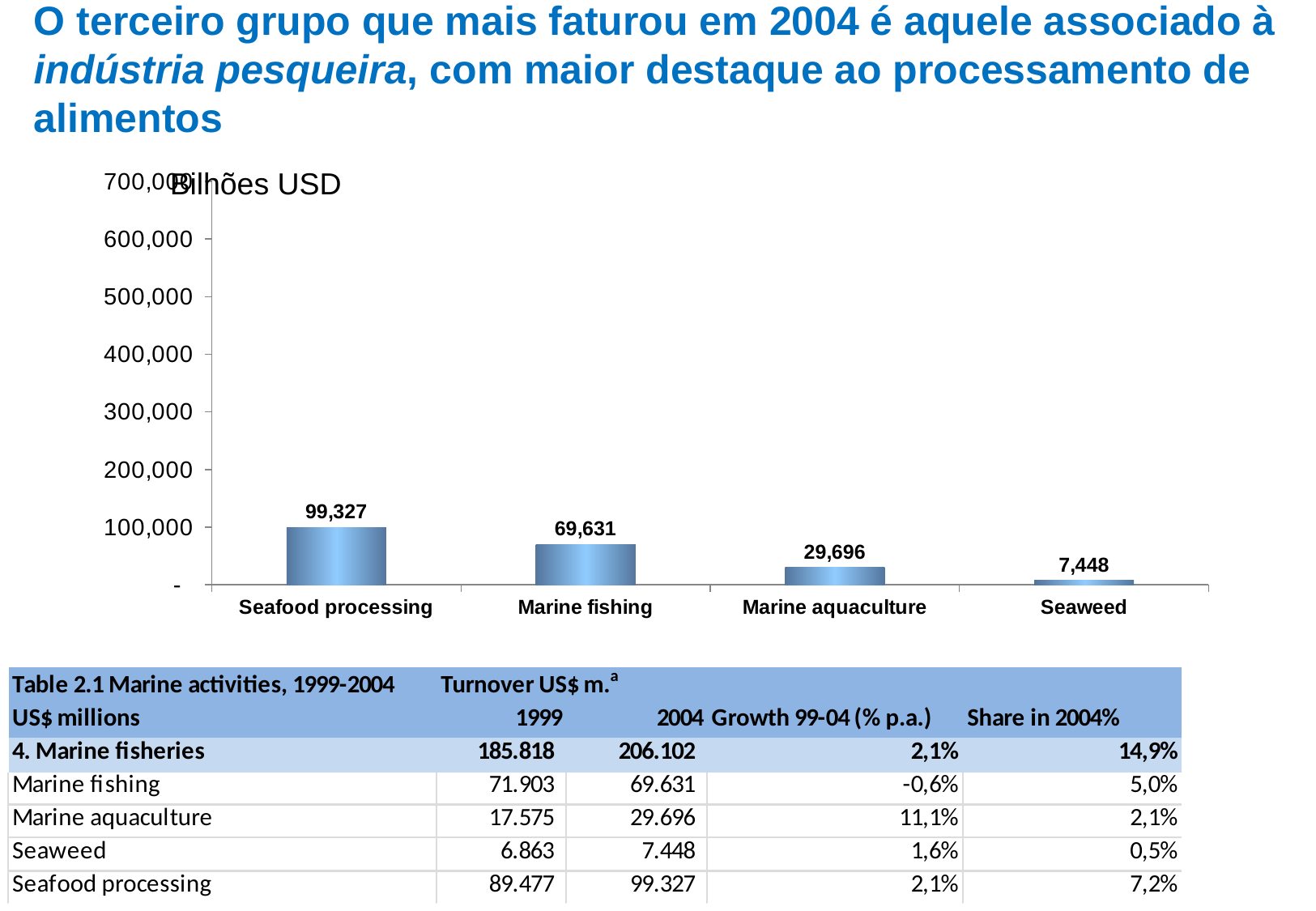
What kind of chart is shown on the slide? Bar chart Which is larger, the value for Marine fishing or the value for Marine aquaculture? Marine fishing How many categories are shown in the chart? 4 What is the value for Marine fishing? 69,631 What is the value for Seafood processing? 99,327 What is the value for Marine aquaculture? 29,696 Which category has the lowest value? Seaweed What is the value for Seaweed? 7,448 What is the difference between the values for Seafood processing and Marine fishing? 29,696 Do the values rise or fall from left to right across the categories? Fall What is the difference between the values for Marine aquaculture and Seaweed? 22,248 Which category has the highest value? Seafood processing